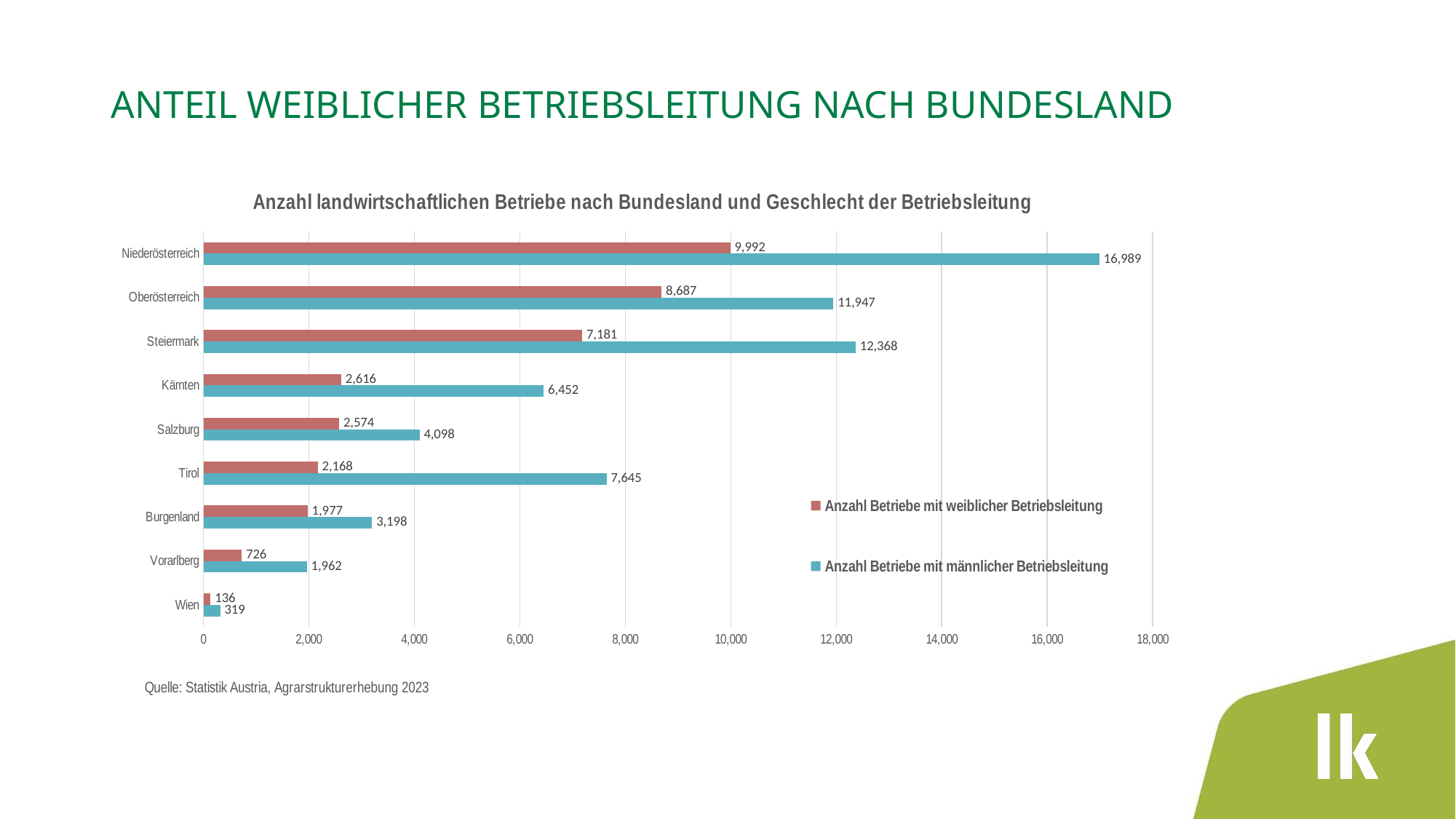
What is the number of farms with female management (Anzahl Betriebe mit weiblicher Betriebsleitung) in Niederösterreich? 9,992 Which Bundesland has the highest number of farms with female management? Niederösterreich How many series does the legend list? 2 What is the value for Tirol in the series Anzahl Betriebe mit männlicher Betriebsleitung? 7,645 What is the number of farms with male management (Anzahl Betriebe mit männlicher Betriebsleitung) in Steiermark? 12,368 Which Bundesland has the lowest number of farms with male management? Wien What is the title of the chart? Anzahl landwirtschaftlichen Betriebe nach Bundesland und Geschlecht der Betriebsleitung What kind of chart is shown on the slide? Bar chart How many Bundesländer are shown on the chart? 9 Which is larger: the number of male-managed farms in Kärnten or in Tirol? Tirol Is the value for Salzburg in the series Anzahl Betriebe mit männlicher Betriebsleitung greater or less than 4,000? greater What is the difference between male-managed and female-managed farms in Oberösterreich? 3,260